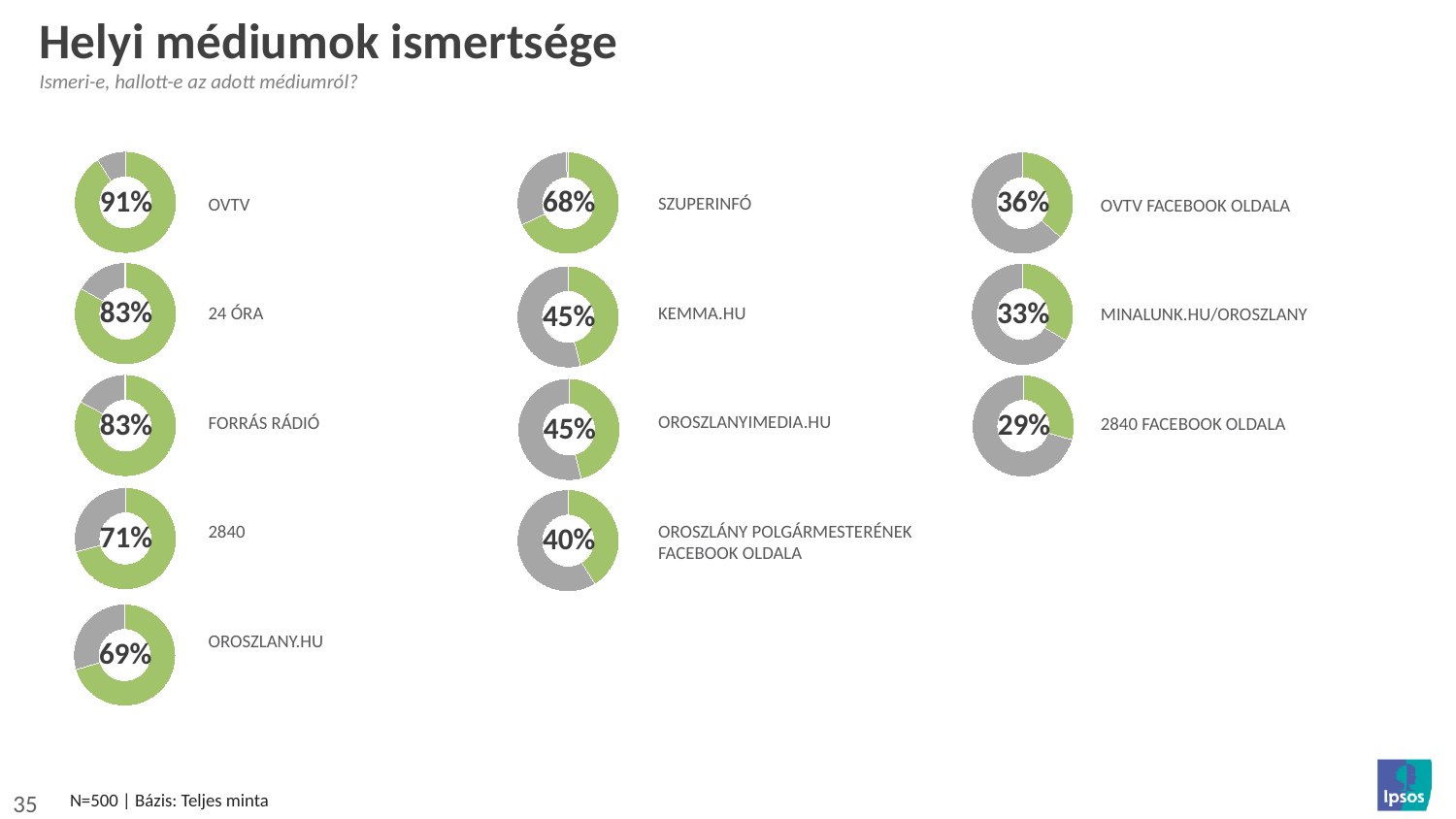
In the donut chart labelled OVTV, what percentage is shown? 91% What is the difference between the percentage in the OVTV chart and the percentage in the OVTV FACEBOOK OLDALA chart? 55% In the donut chart labelled SZUPERINFÓ, what percentage is shown? 68% Which is larger: the percentage in the KEMMA.HU chart or the percentage in the MINALUNK.HU/OROSZLANY chart? KEMMA.HU Across all the donut charts on the slide, which medium has the highest percentage? OVTV How many donut charts are shown on the slide? 12 Across all the donut charts on the slide, which medium has the lowest percentage? 2840 FACEBOOK OLDALA What is the title of the slide containing the donut charts? Helyi médiumok ismertsége In the donut chart labelled OROSZLÁNY POLGÁRMESTERÉNEK FACEBOOK OLDALA, what percentage is shown? 40% What type of chart is used for each medium on the slide? Donut chart In the 24 ÓRA chart, what share of the donut is shown as the green segment? 83% In the donut chart labelled 2840 FACEBOOK OLDALA, what percentage is shown? 29%